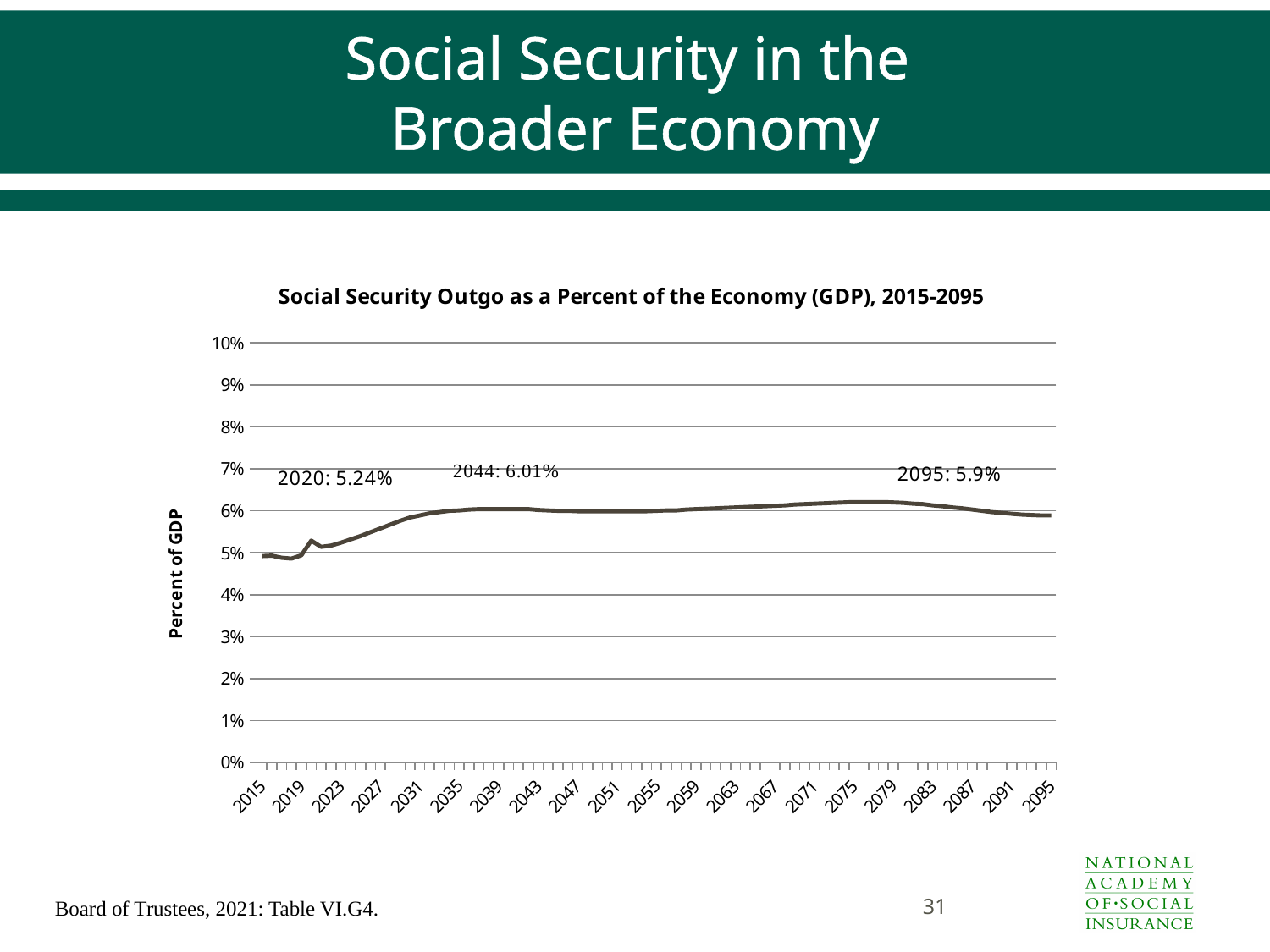
Is the value for 2079 greater or less than 5%? greater Which year has the higher labeled value, 2020 or 2095? 2095 What is the Social Security outgo as a percent of GDP in 2044? 6.01% By how many percentage points does the labeled value for 2044 exceed the labeled value for 2020? 0.77 percentage points Does the line rise or fall between 2020 and 2044? rise Is the value for 2015 greater or less than 6%? less What is the Social Security outgo as a percent of GDP in 2095? 5.9% What is the Social Security outgo as a percent of GDP in 2020? 5.24% By how many percentage points does the labeled value for 2044 exceed the labeled value for 2095? 0.11 percentage points What type of chart is shown on the slide? line chart What is the title of the chart? Social Security Outgo as a Percent of the Economy (GDP), 2015-2095 What is the label on the vertical axis of the chart? Percent of GDP